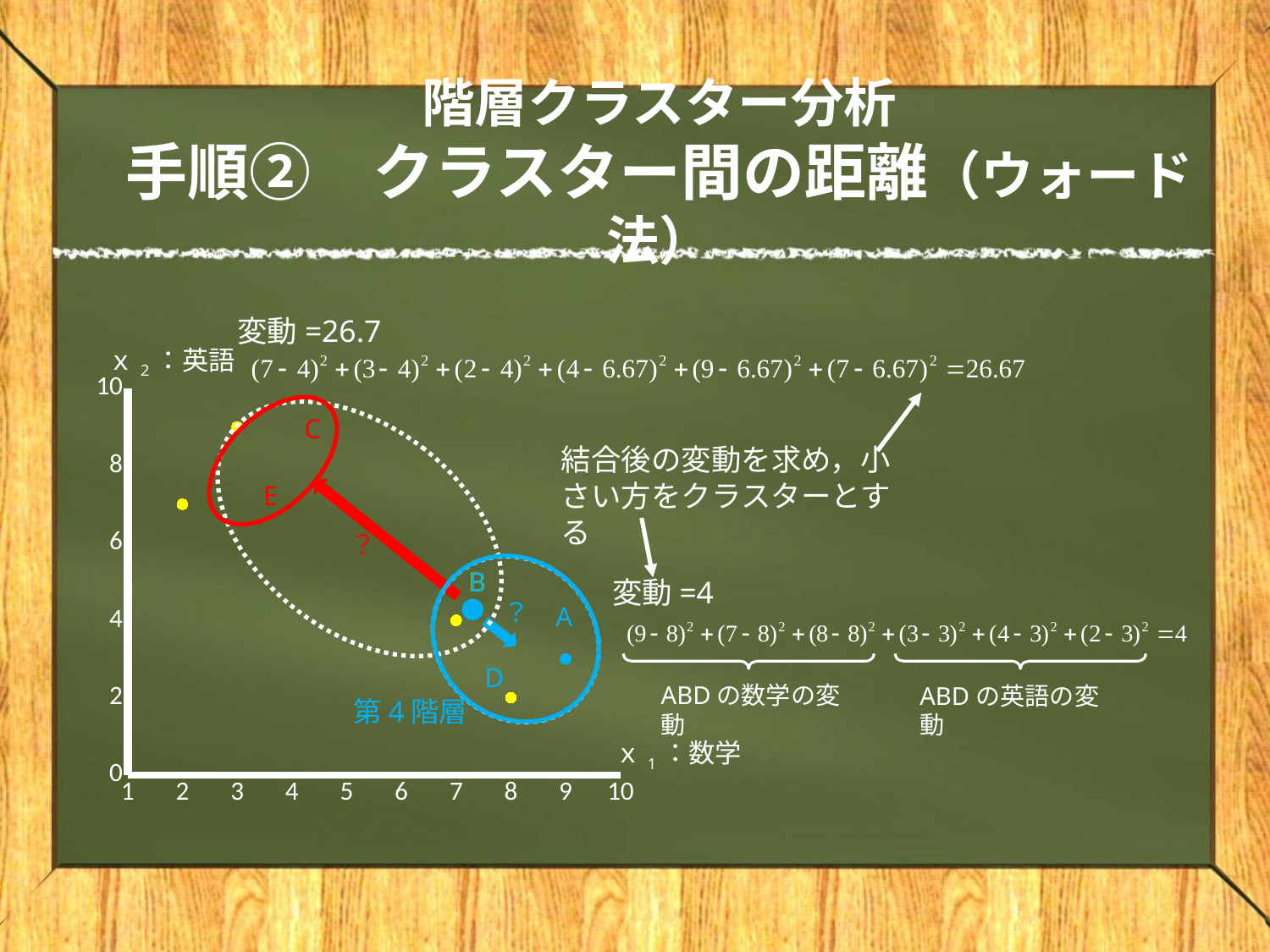
Is the 英語 (x2) value for point D greater or less than 4? less Which point has the lowest 数学 (x1) value? E How many labeled data points (A–E) are plotted on the chart? 5 Which point has the lowest 英語 (x2) value? D Is the 数学 (x1) value for point E greater or less than 4? less What kind of chart is shown on the slide? scatter plot Which point has the highest 英語 (x2) value? C What is the label of the horizontal axis of the chart? x1：数学 Is the 英語 (x2) value for point C greater or less than 8? greater Which point has a larger 数学 (x1) value, A or B? A What is the 変動 (variation) value shown for the cluster ABD? 4 What is the label of the vertical axis of the chart? x2：英語